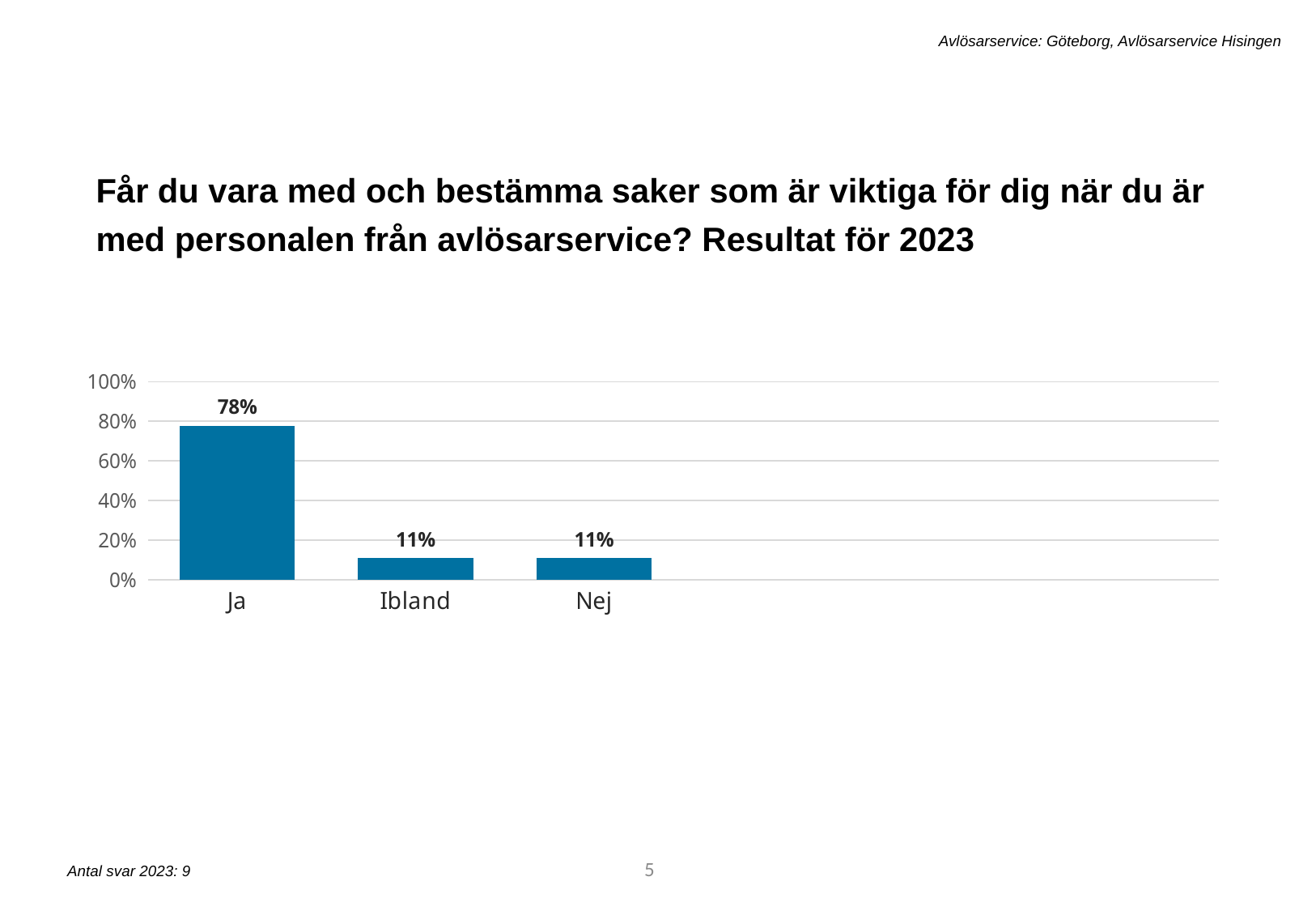
What is the value for Nej? 11% What is the value for Ibland? 11% What kind of chart is shown on the slide? bar chart What is the value for Ja? 78% How many categories are shown on the x axis? 3 Is the value for Ibland greater or less than 20%? less Which is larger, the value for Ja or the value for Ibland? Ja How many responses (Antal svar) were recorded for 2023 according to the slide? 9 What is the highest value shown on the y axis? 100% Is the value for Ja greater or less than 60%? greater What is the difference between the values for Ja and Nej? 67% Which category has the highest value? Ja